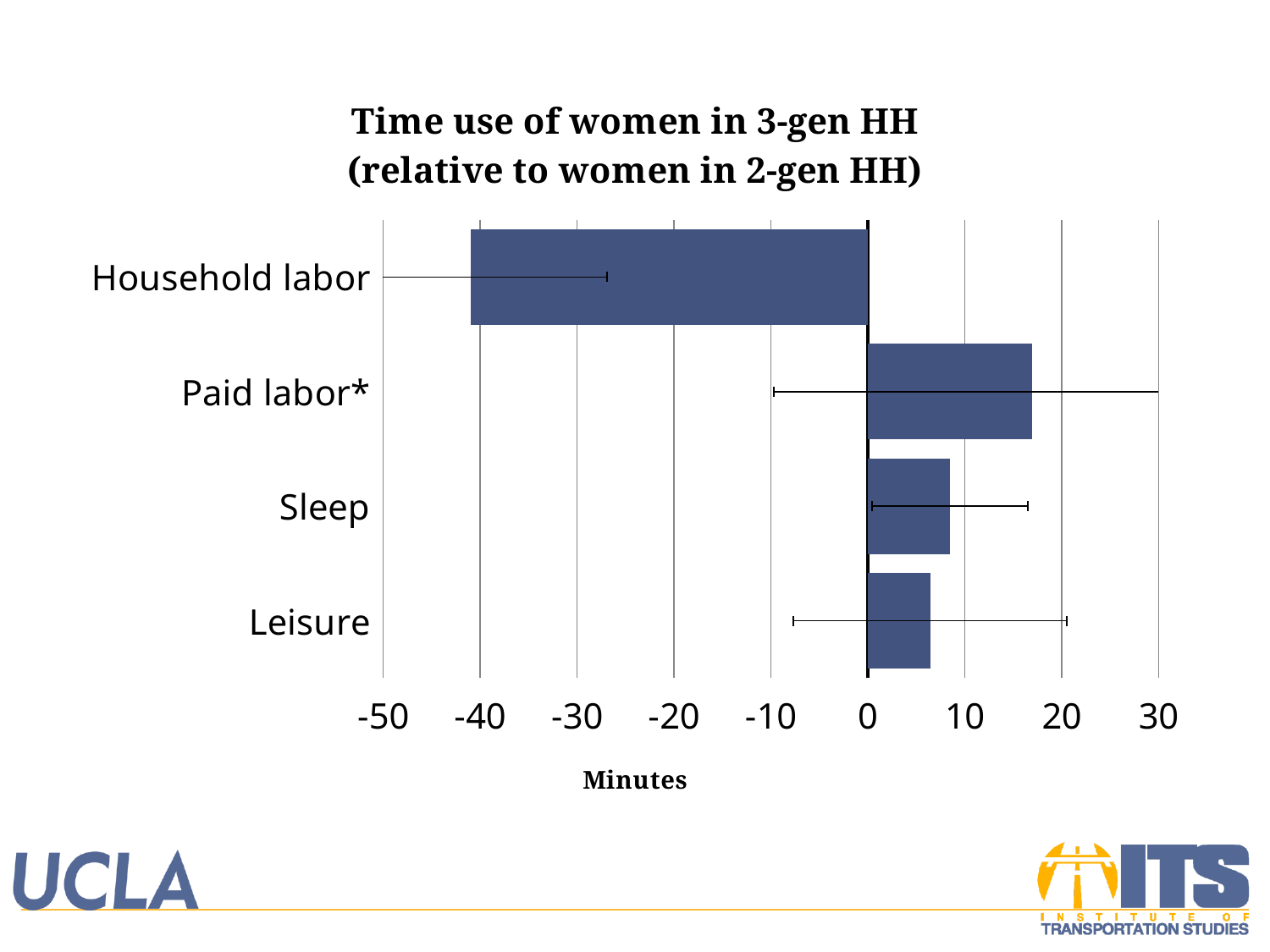
What is the title of the chart? Time use of women in 3-gen HH (relative to women in 2-gen HH) Which category has the highest value? Paid labor* Which category has the lowest value? Household labor Which is larger, the value for Paid labor* or the value for Sleep? Paid labor* Is the value for Sleep greater or less than 10? less What kind of chart is shown on the slide? bar chart Is the value for Paid labor* greater or less than 10? greater Is the value for Leisure greater or less than 0? greater Which is larger, the value for Household labor or the value for Leisure? Leisure What is the title of the x axis? Minutes How many categories are plotted in the chart? 4